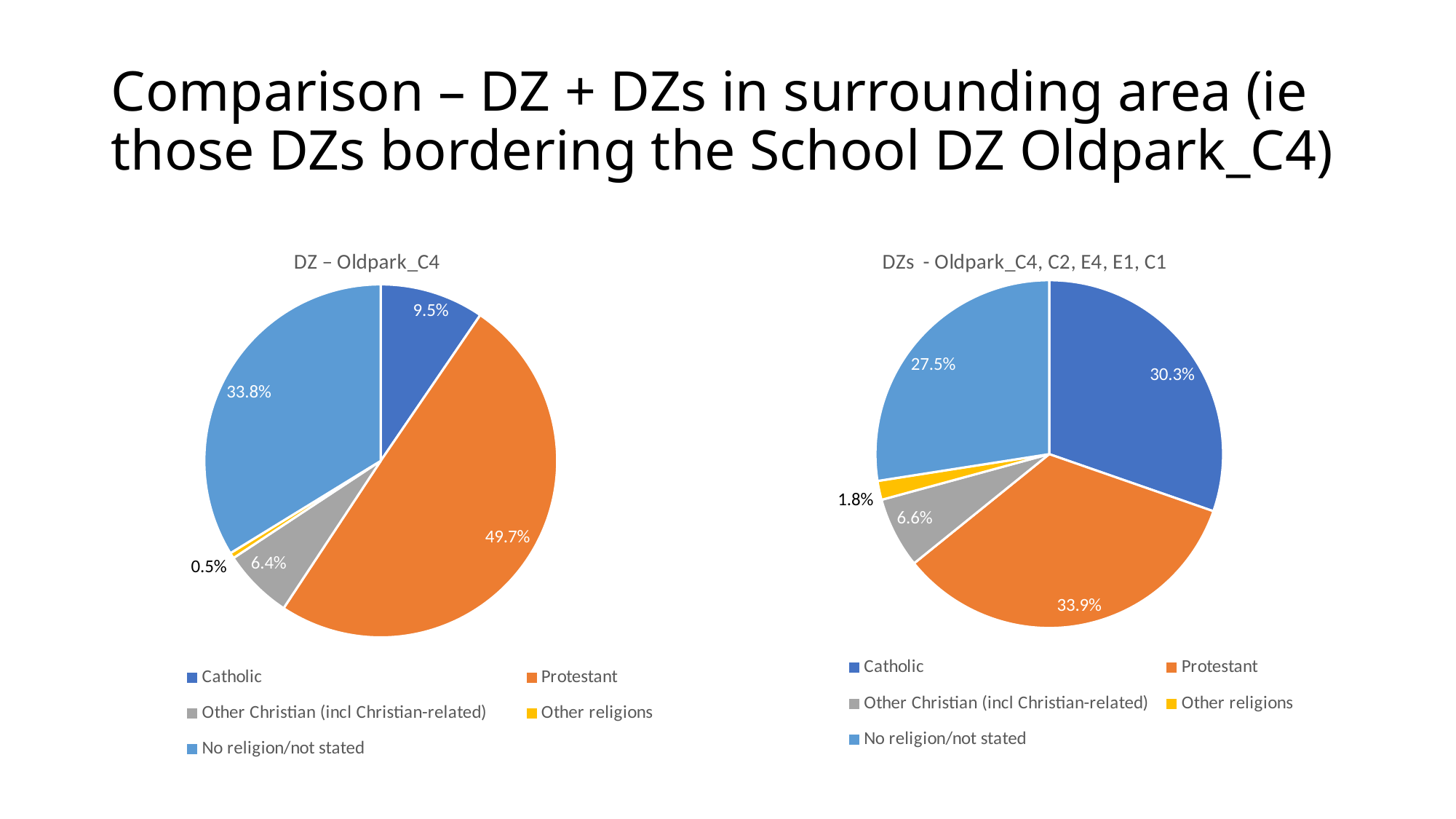
In the 'DZs - Oldpark_C4, C2, E4, E1, C1' pie chart, which is larger: Catholic or No religion/not stated? Catholic What is the difference between the Catholic share in the 'DZs - Oldpark_C4, C2, E4, E1, C1' chart and the Catholic share in the 'DZ – Oldpark_C4' chart? 20.8% In the 'DZ – Oldpark_C4' pie chart, what percentage is shown for Protestant? 49.7% In the 'DZs - Oldpark_C4, C2, E4, E1, C1' pie chart, what percentage is shown for Catholic? 30.3% How many categories does the legend of the 'DZ – Oldpark_C4' chart list? 5 In the 'DZ – Oldpark_C4' pie chart, which category has the smallest share? Other religions In the 'DZs - Oldpark_C4, C2, E4, E1, C1' pie chart, which category has the largest share? Protestant In the 'DZ – Oldpark_C4' pie chart, what percentage is shown for No religion/not stated? 33.8% In the 'DZ – Oldpark_C4' pie chart, what percentage is shown for Catholic? 9.5% What type of chart is used on the left of the slide? Pie chart In the 'DZs - Oldpark_C4, C2, E4, E1, C1' pie chart, what percentage is shown for Other religions? 1.8% In the 'DZ – Oldpark_C4' pie chart, which category has the largest share? Protestant